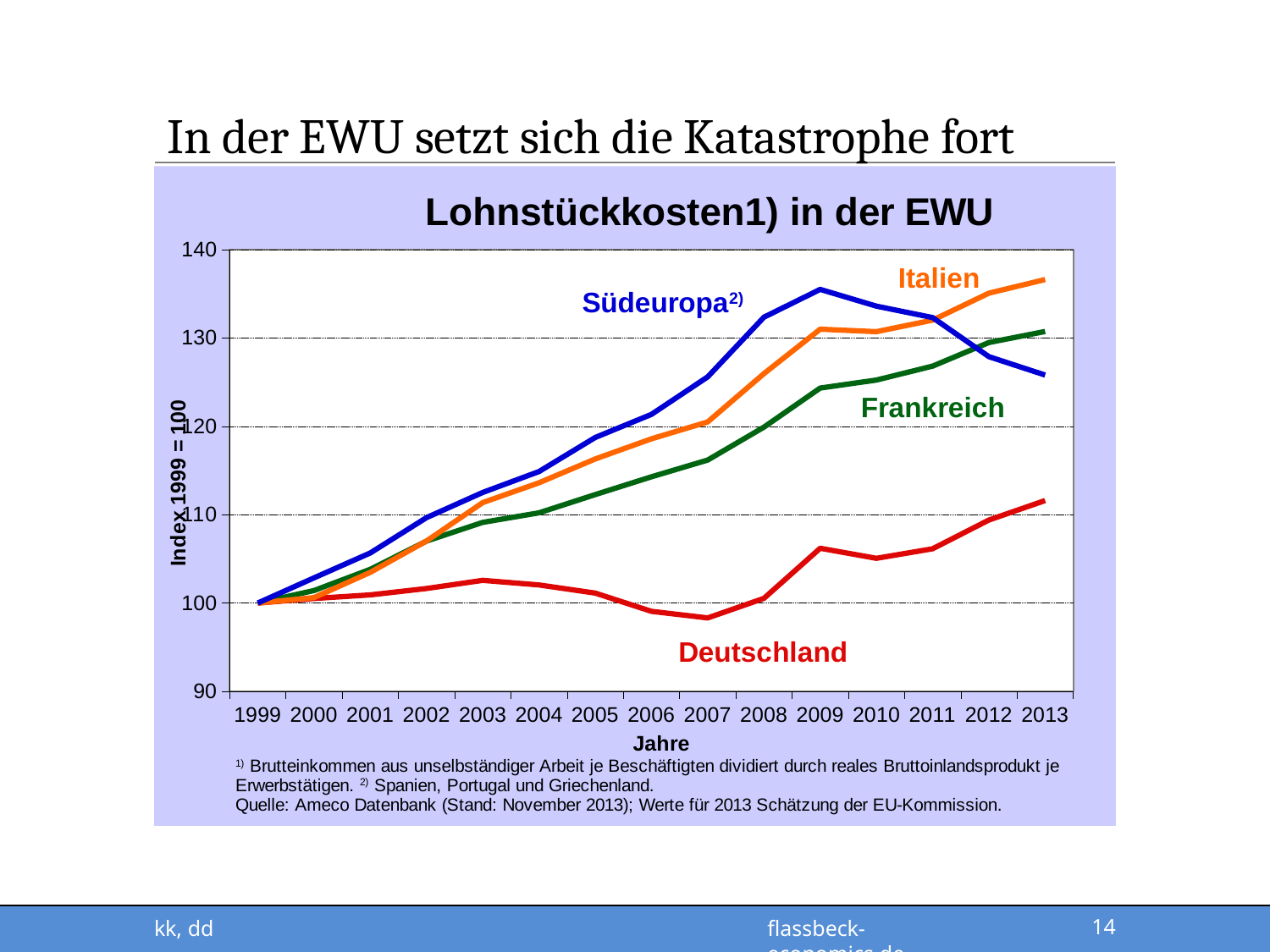
How many series are plotted in the chart? 4 How many years are shown on the x axis of the chart? 15 What is the label of the y axis of the chart? Index 1999 = 100 What is the value for Deutschland in 1999? 100 Is the value for Südeuropa in 2009 greater or less than 130? greater Which series has the highest value in 2009? Südeuropa What type of chart is shown on the slide? line chart Which series has the lowest value in 2013? Deutschland In 2013, which is larger: the value for Südeuropa or the value for Italien? Italien Which series has the highest value in 2013? Italien Is the value for Südeuropa in 2013 greater or less than 130? less Does the value for Südeuropa rise or fall between 2009 and 2013? fall